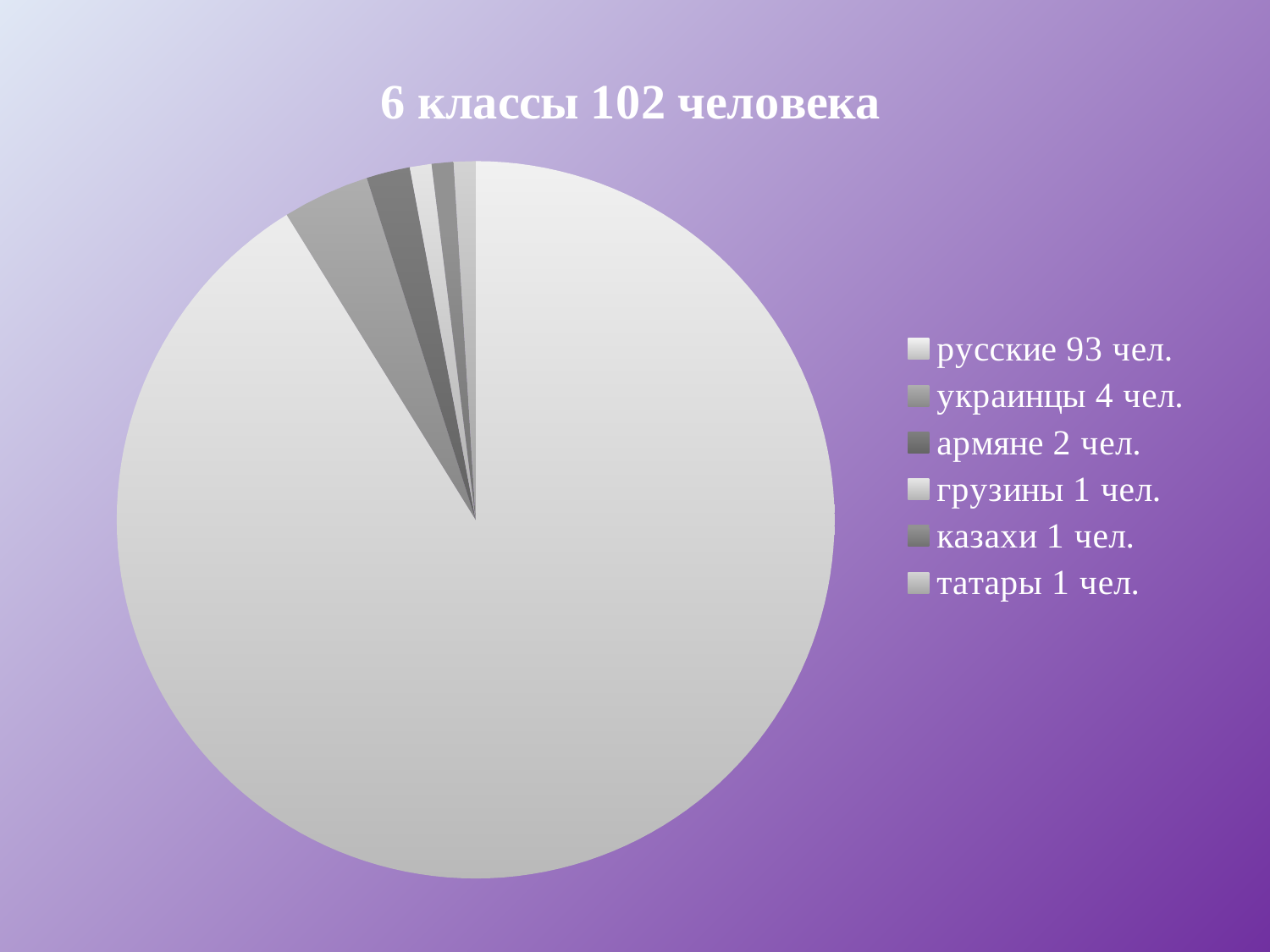
Which is larger, the value for украинцы or the value for армяне? украинцы What is the difference between the number of русские and the number of украинцы? 89 How many people are грузины according to the legend? 1 чел. How many categories does the legend list? 6 What is the title of the chart? 6 классы 102 человека What kind of chart is shown on the slide? pie chart How many people are армяне according to the legend? 2 чел. What is the total number of people represented in the chart, as stated in the title? 102 How many people are украинцы according to the legend? 4 чел. Which category has the largest slice of the pie? русские What is the difference between the number of украинцы and the number of армяне? 2 How many people are русские according to the legend? 93 чел.